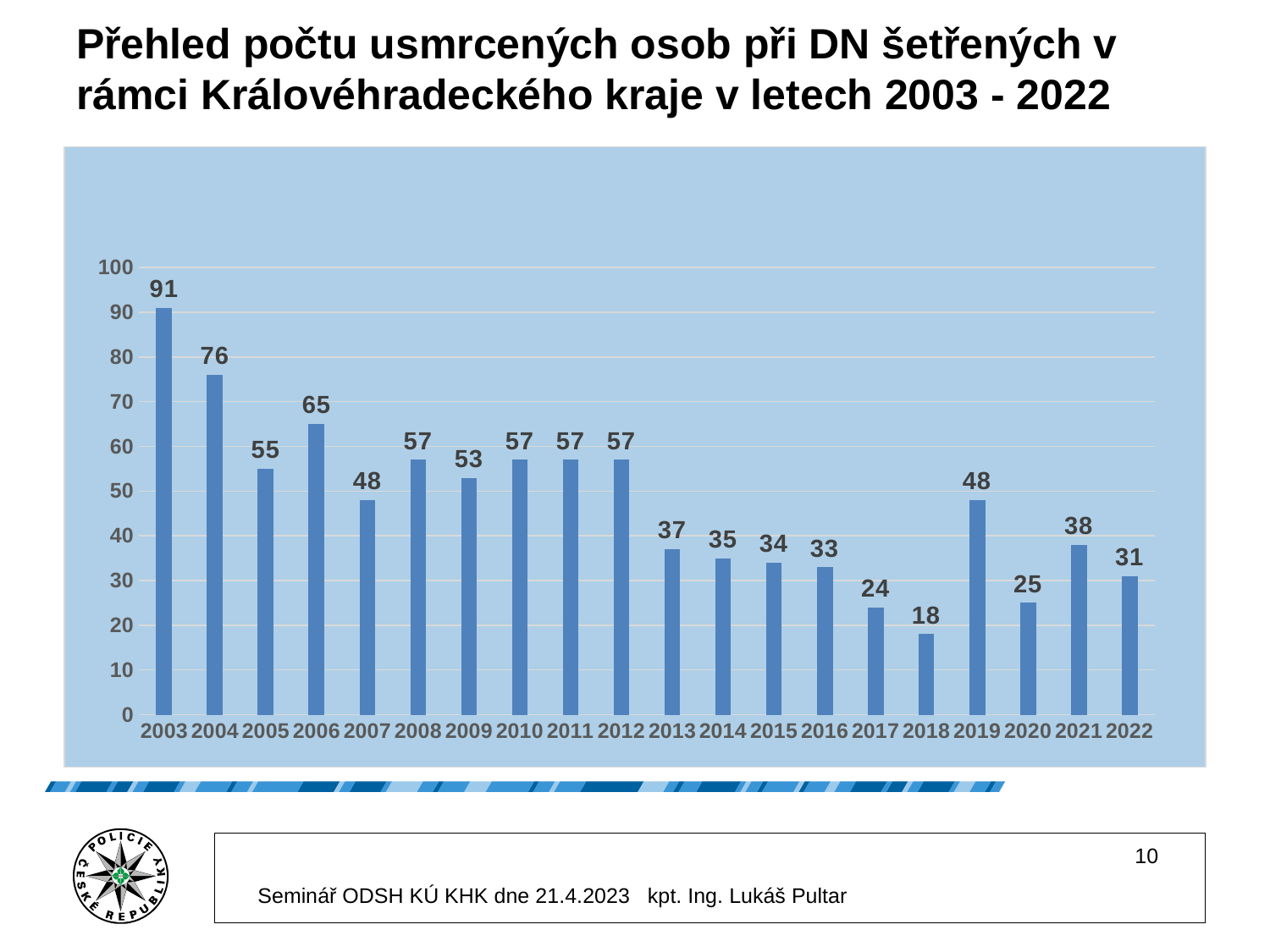
How many years are shown on the x axis? 20 What is the value for 2018? 18 What is the value for 2003? 91 Which is larger, the value for 2006 or the value for 2008? 2006 What kind of chart is shown on the slide? bar chart What is the difference between the values for 2021 and 2022? 7 Is the value for 2017 greater or less than 30? less Which year has the highest value? 2003 Do the values generally rise or fall from 2003 to 2018? fall What is the value for 2019? 48 What is the difference between the values for 2003 and 2004? 15 Which year has the lowest value? 2018